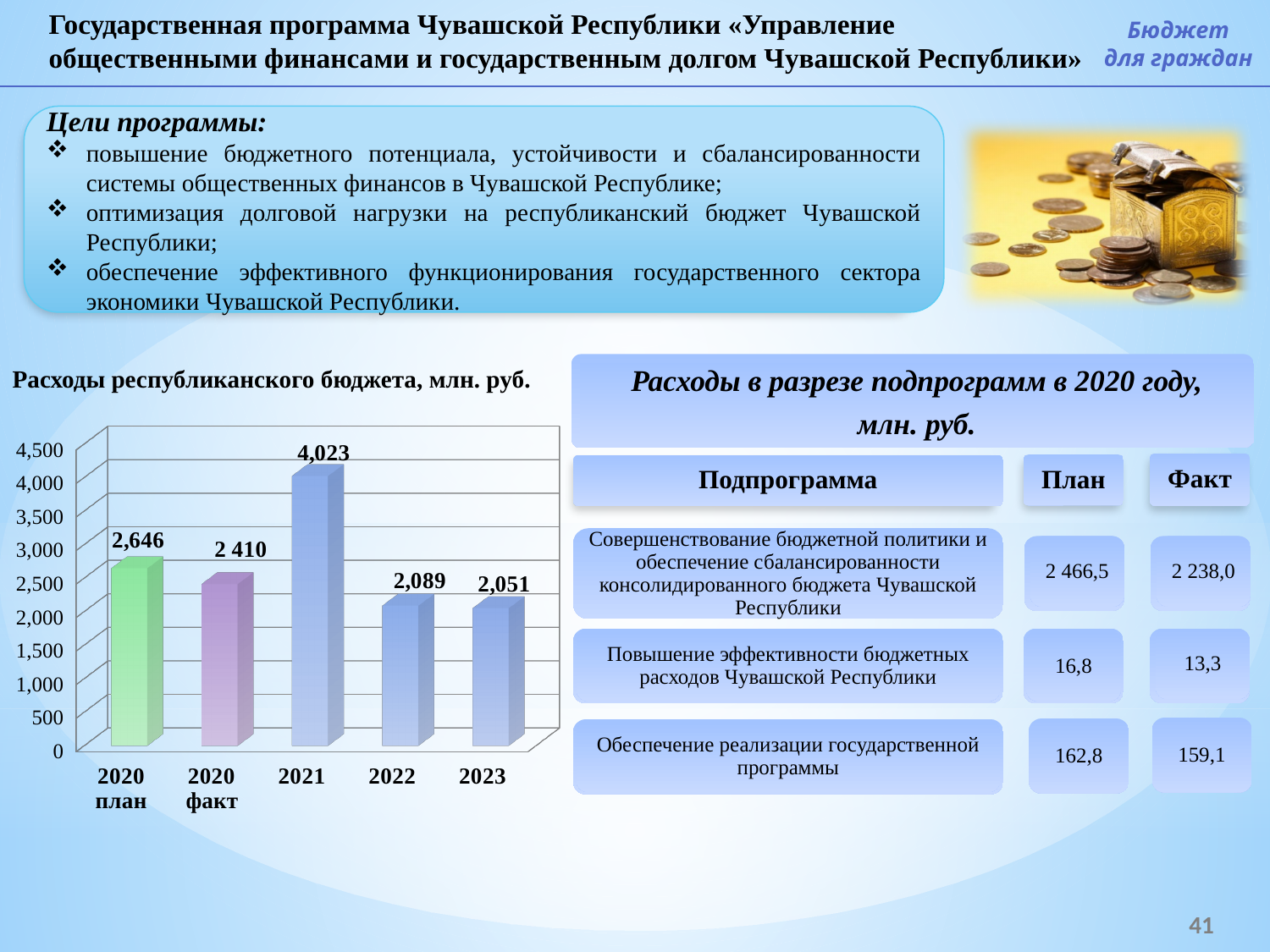
Which category has the highest value in the chart 'Расходы республиканского бюджета, млн. руб.'? 2021 Which category has the lowest value in the chart 'Расходы республиканского бюджета, млн. руб.'? 2023 In the chart 'Расходы республиканского бюджета, млн. руб.', which is larger: the value for 2022 or the value for 2023? 2022 In the chart 'Расходы республиканского бюджета, млн. руб.', is the value for 2021 greater or less than 4,000? greater In the chart 'Расходы республиканского бюджета, млн. руб.', what is the difference between the 2021 value and the 2022 value? 1,934 How many categories are shown on the x axis of the chart 'Расходы республиканского бюджета, млн. руб.'? 5 What is the value for 2021 in the chart 'Расходы республиканского бюджета, млн. руб.'? 4,023 What is the value for '2020 факт' in the chart 'Расходы республиканского бюджета, млн. руб.'? 2 410 What kind of chart is 'Расходы республиканского бюджета, млн. руб.'? bar chart What is the value for 2023 in the chart 'Расходы республиканского бюджета, млн. руб.'? 2,051 What is the value for '2020 план' in the chart 'Расходы республиканского бюджета, млн. руб.'? 2,646 In the chart 'Расходы республиканского бюджета, млн. руб.', what is the difference between '2020 план' and '2020 факт'? 236